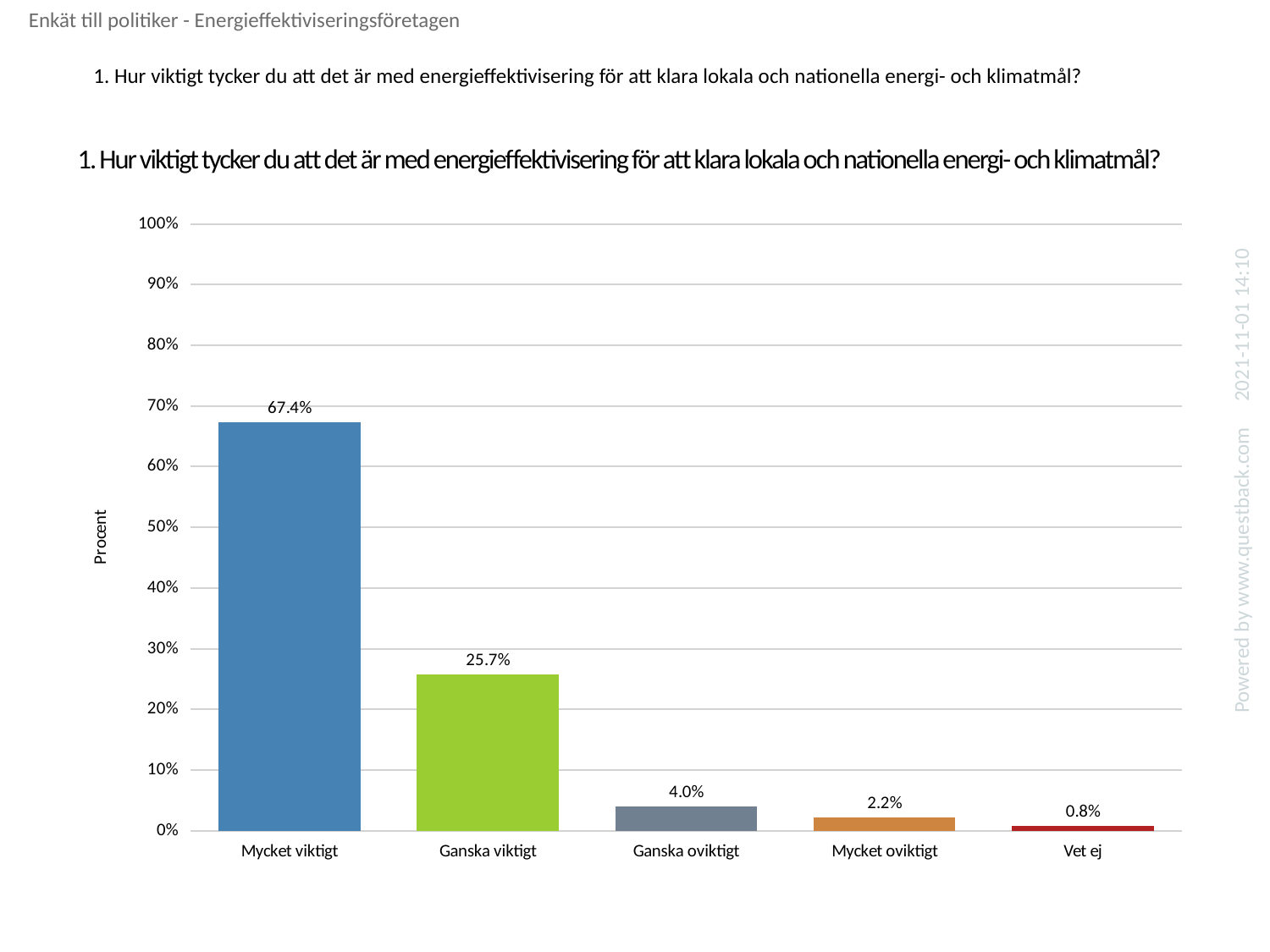
Which category has the highest value? Mycket viktigt What is the difference between the values for "Mycket viktigt" and "Ganska viktigt"? 41.7% Which is larger, the value for "Ganska oviktigt" or the value for "Mycket oviktigt"? Ganska oviktigt How many categories are shown on the x axis? 5 What is the label of the y axis? Procent Is the value for "Ganska viktigt" greater or less than 30%? less What kind of chart is shown on the slide? bar chart What is the value for "Ganska oviktigt"? 4.0% Which category has the lowest value? Vet ej What is the value for "Mycket viktigt"? 67.4% What is the value for "Vet ej"? 0.8% What is the value for "Ganska viktigt"? 25.7%